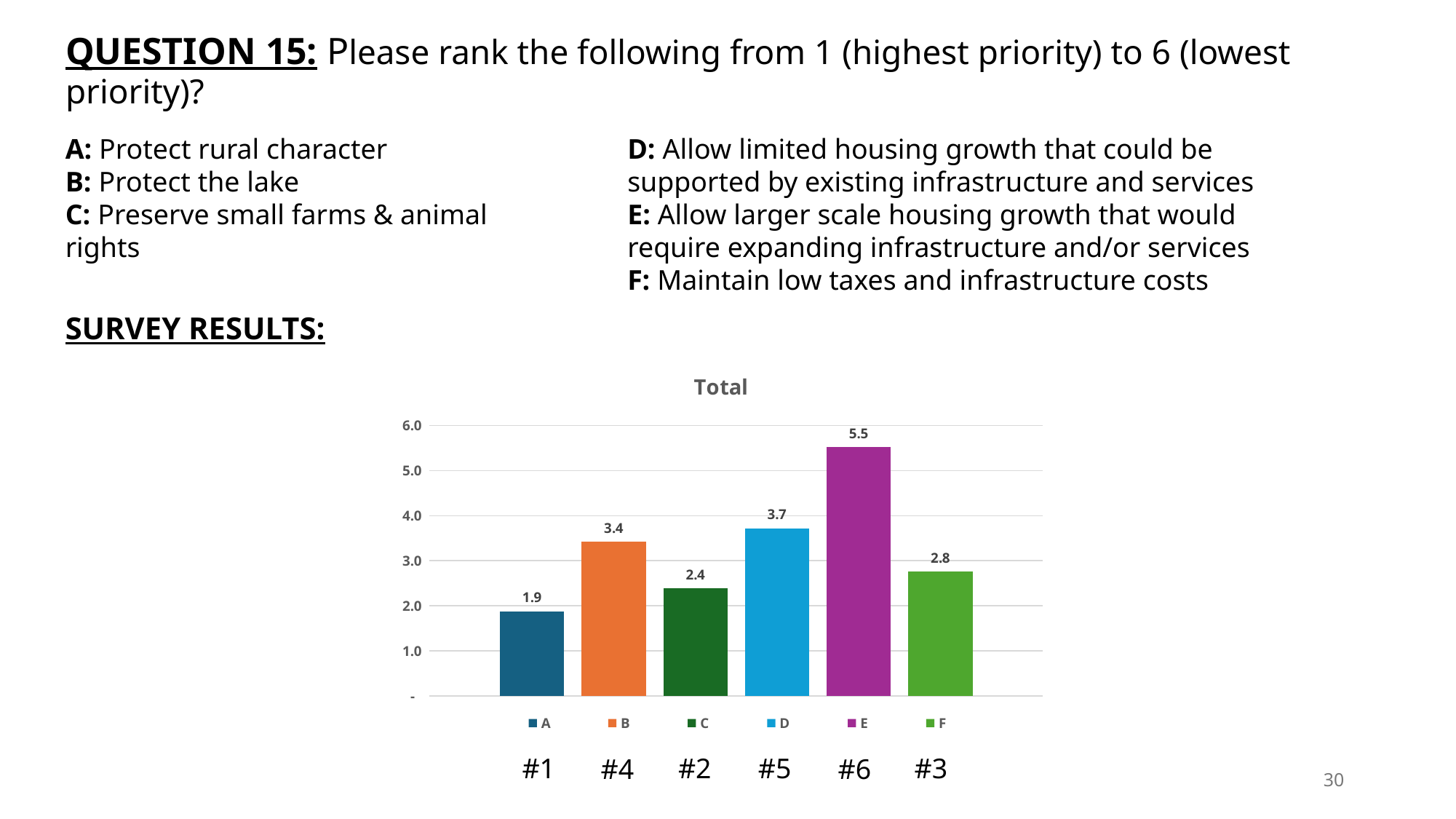
Is the value for C greater or less than 3.0? less What is the value for D in the Total chart? 3.7 What kind of chart is shown on the slide? bar chart Which category has the lowest value in the Total chart? A Which category has the highest value in the Total chart? E What is the title of the chart? Total Which is larger, the value for B or the value for F? B What is the difference between the values for B and C? 1.0 What is the value for E in the Total chart? 5.5 What is the value for A in the Total chart? 1.9 How many categories are shown in the Total chart? 6 What is the difference between the values for E and A? 3.6